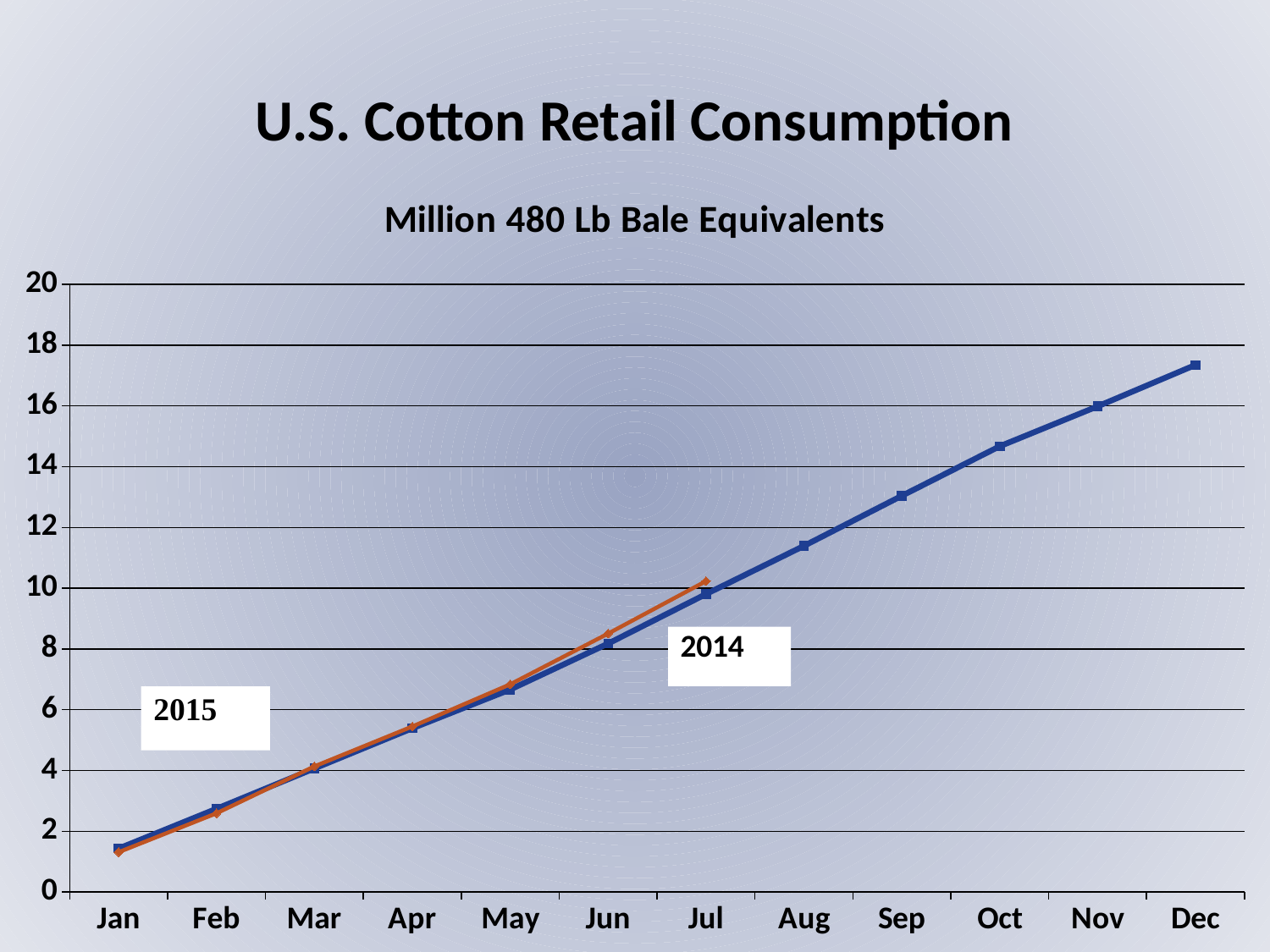
Is the 2014 value for Jan greater or less than 2? less In which month is the 2014 series at its highest? Dec How many data series are plotted on the chart? 2 What unit is given in the chart's subtitle? Million 480 Lb Bale Equivalents How many months are shown on the x axis? 12 What is the last month for which the 2015 series has a data point? Jul Do the values for the 2014 series rise or fall from Jan to Dec? rise Is the 2014 value for Apr greater or less than 6? less In which month is the 2014 series at its lowest? Jan Is the 2014 value for Aug greater or less than 10? greater What kind of chart is shown on the slide? line chart